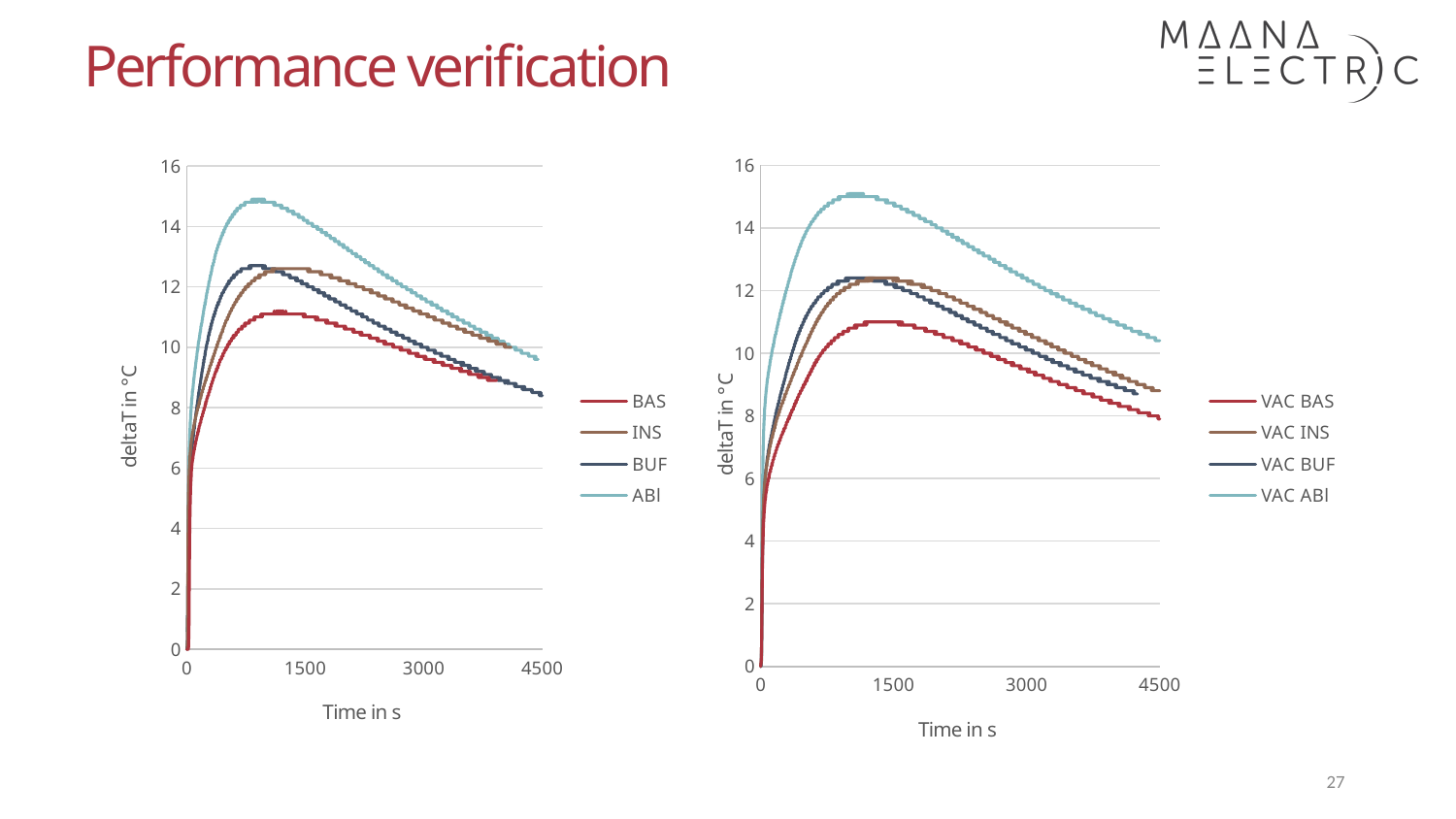
In the left chart, after reaching its peak, does the ABl series rise or fall as time increases toward 4500 s? fall What is the y-axis title of the right chart? deltaT in °C In the right chart, is the peak value of VAC BAS greater or less than 12? less In the left chart, which series reaches the highest deltaT? ABl In the left chart, which series has the lowest peak deltaT? BAS In the right chart, which series has the lowest peak deltaT? VAC BAS How many series does the legend of the right chart list? 4 In the right chart, which series is higher at 4500 s: VAC ABl or VAC BAS? VAC ABl How many series does the legend of the left chart list? 4 In the right chart, which series reaches the highest deltaT? VAC ABl In the left chart, is the peak value of ABl greater or less than 14? greater What kind of chart is the left chart on the slide? line chart